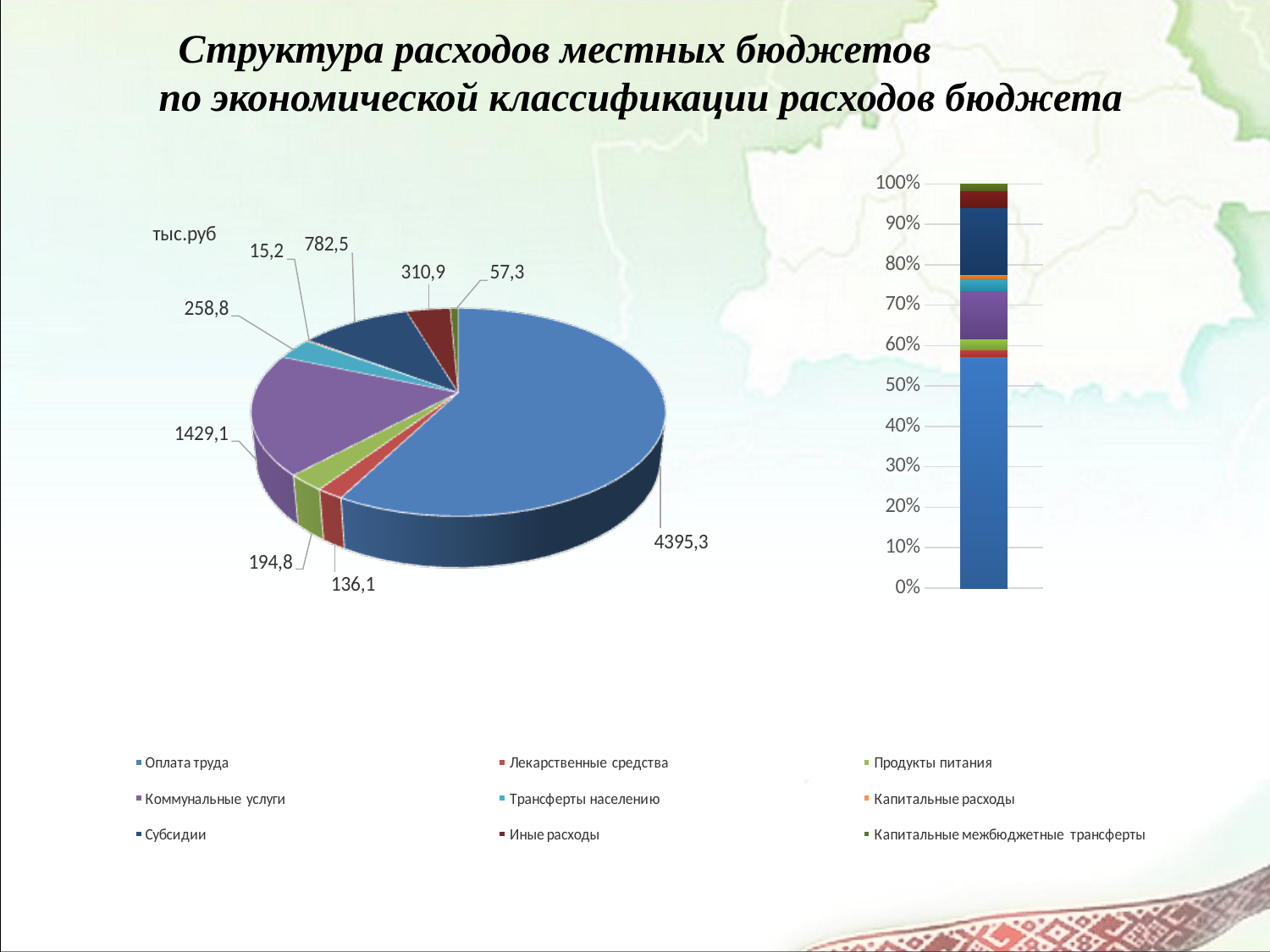
In the pie chart, which is larger: Продукты питания or Капитальные межбюджетные трансферты? Продукты питания How many categories does the legend list? 9 What kind of chart is the chart on the left? pie chart In the pie chart, what is the difference between the values for Иные расходы and Лекарственные средства? 174,8 In the pie chart, what is the value for Оплата труда? 4395,3 What unit is shown next to the pie chart? тыс.руб In the pie chart, which category has the largest value? Оплата труда In the pie chart, what is the value for Трансферты населению? 258,8 In the pie chart, which category has the smallest value? Капитальные расходы In the pie chart, what is the value for Коммунальные услуги? 1429,1 In the stacked bar chart on the right, is the share for Оплата труда greater or less than 50%? greater In the pie chart, what is the value for Субсидии? 782,5